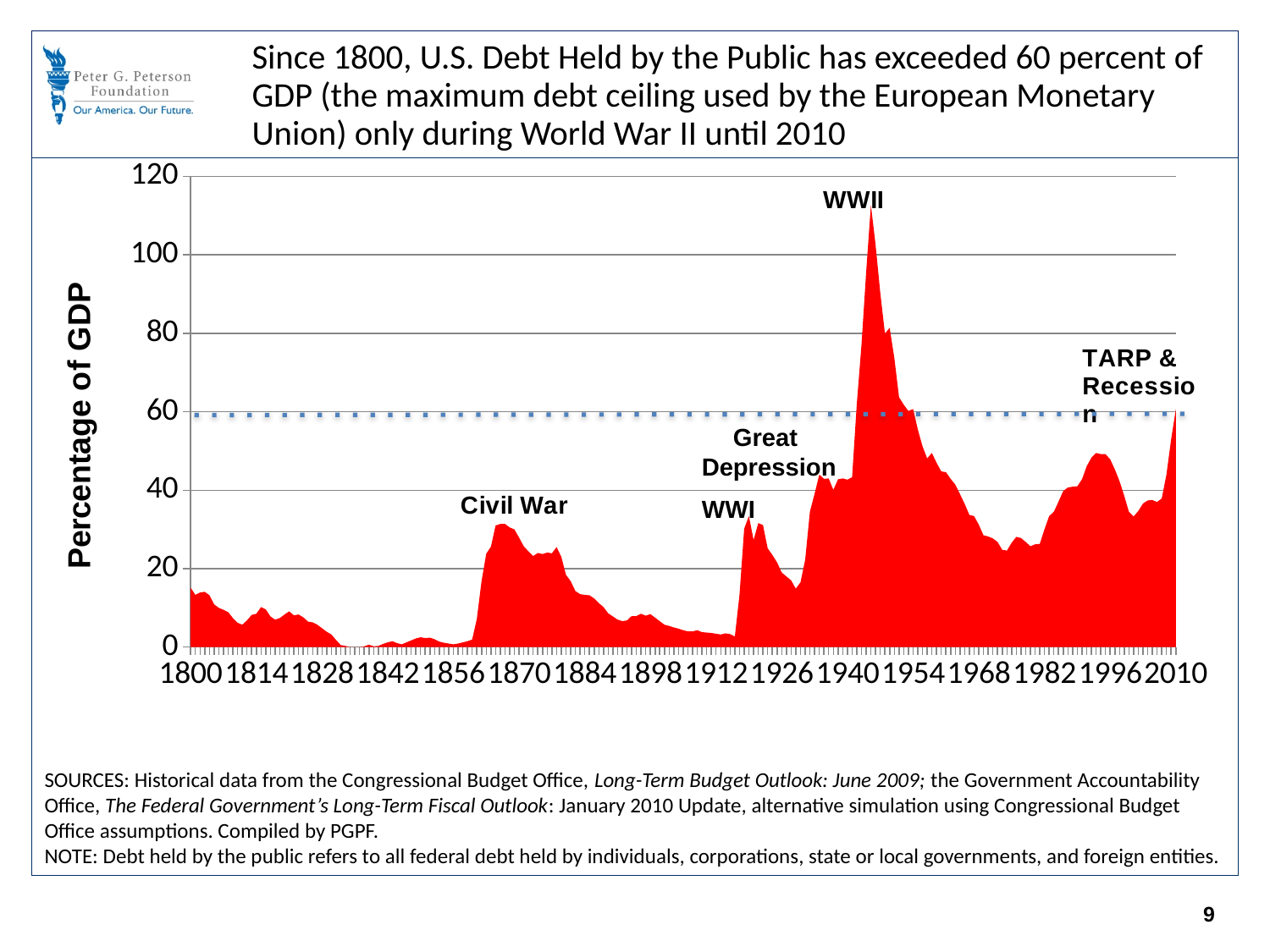
What is the first year and the last year shown on the x-axis? 1800 and 2010 At what percentage of GDP is the horizontal dotted reference line drawn? 60 Is the peak value during WWII greater or less than 100 percent of GDP? greater Which is larger, the peak during WWII or the peak during the Civil War? WWII Is the peak value during the Great Depression greater or less than 60 percent of GDP? less Does the debt as a percentage of GDP rise or fall between 1800 and 1842? Fall Is the peak value around WWI greater or less than 40 percent of GDP? less Which labeled event corresponds to the highest peak in debt held by the public as a percentage of GDP? WWII What kind of chart is shown on the slide? Area chart What is the label of the y-axis? Percentage of GDP